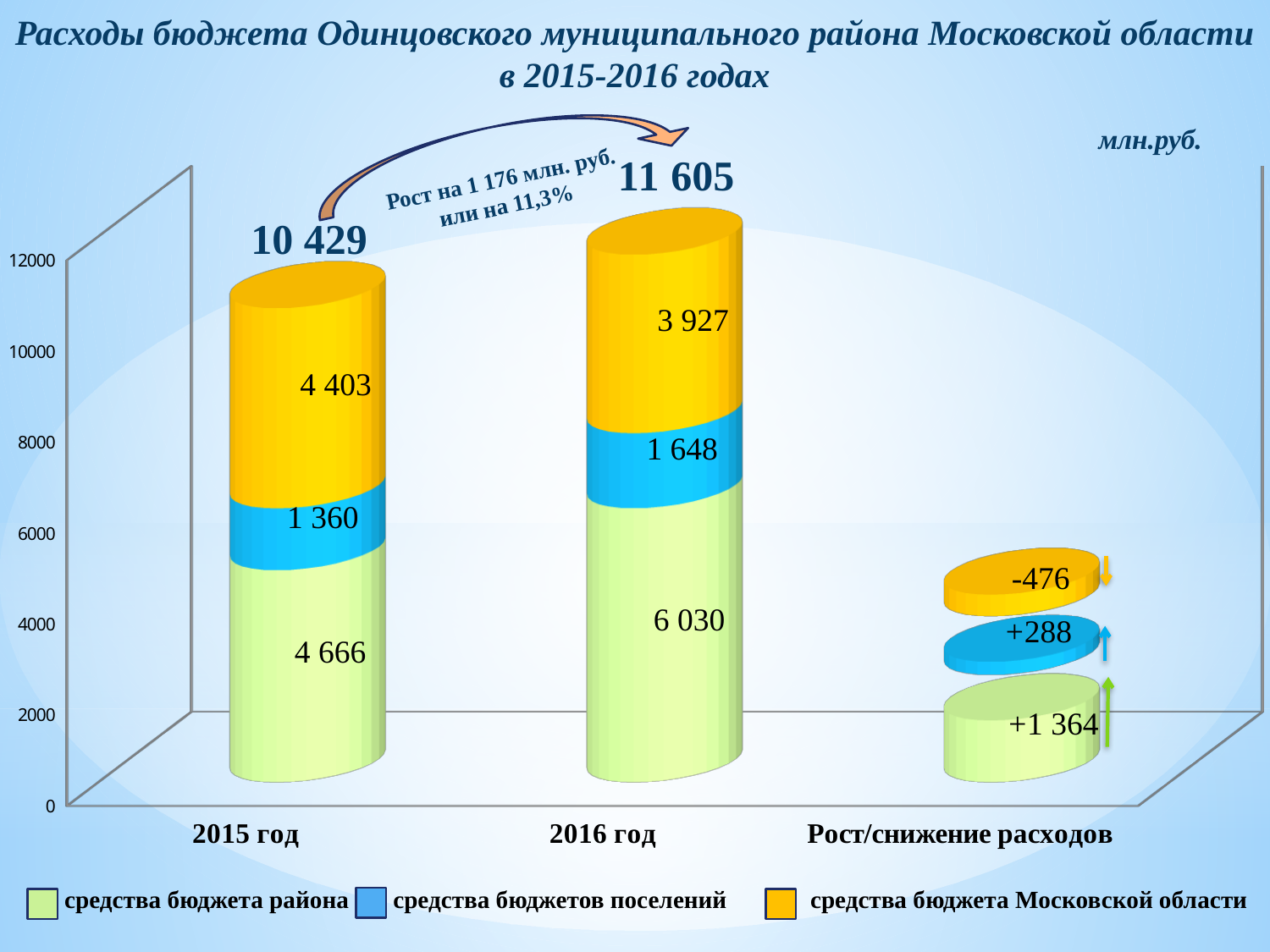
Which series has the largest value in 2015 год? средства бюджета района What is the value for средства бюджета района in 2015 год? 4 666 Does the total expenditure rise or fall from 2015 год to 2016 год? rise What is the total of the stacked bar for 2016 год? 11 605 In 2016 год, which is larger: средства бюджета района or средства бюджета Московской области? средства бюджета района What is the value for средства бюджета Московской области in 2016 год? 3 927 What change is shown for средства бюджета Московской области in the Рост/снижение расходов category? -476 What is the value for средства бюджетов поселений in 2015 год? 1 360 How many series does the legend list? 3 What kind of chart is shown on the slide? bar chart What is the total of the stacked bar for 2015 год? 10 429 By how much does средства бюджетов поселений in 2016 год exceed its value in 2015 год? 288